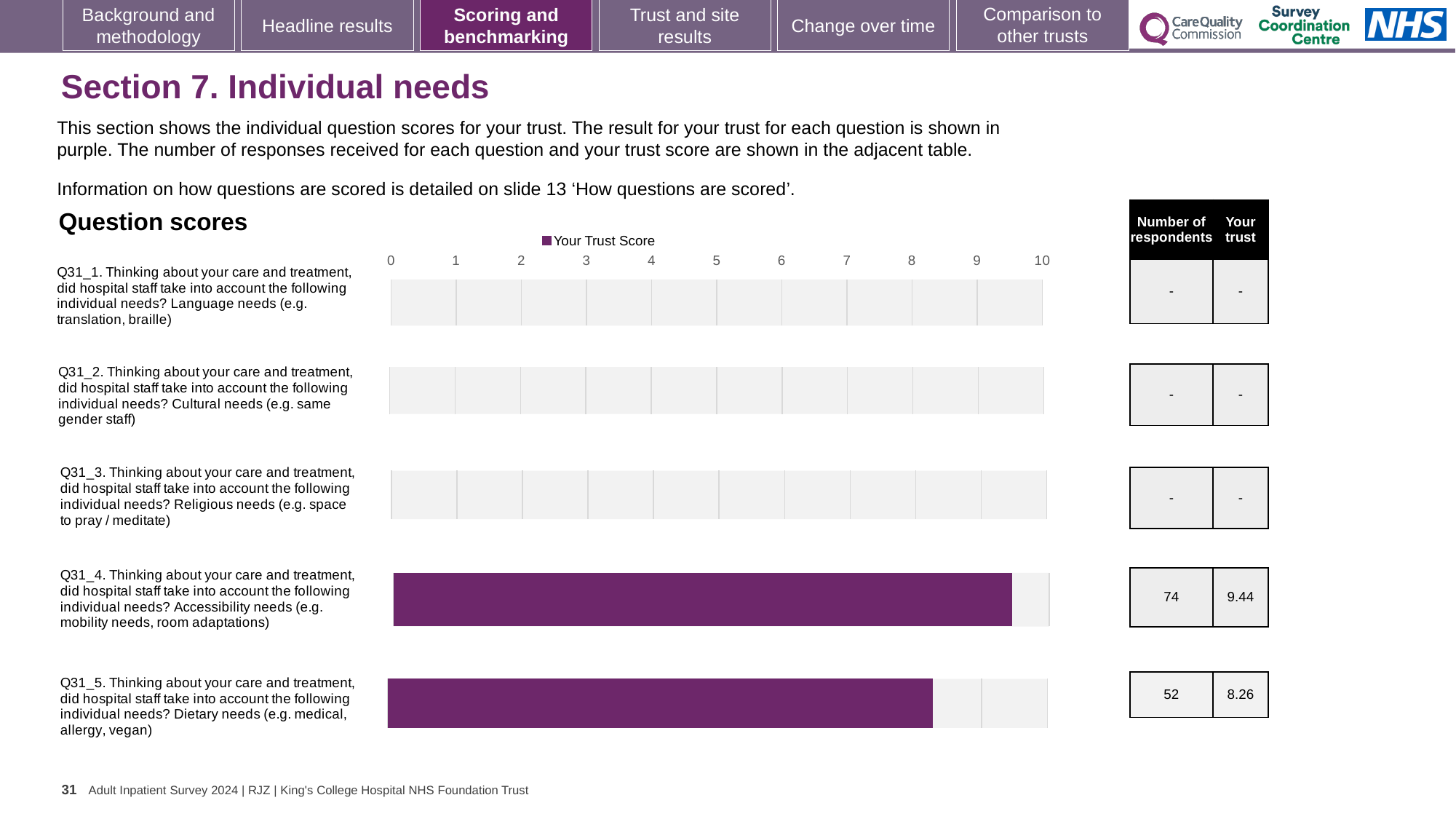
Which question has the highest trust score shown on the chart? Q31_4 (Accessibility needs) What series name is shown in the chart legend? Your Trust Score What is the trust score for Q31_4 (Accessibility needs)? 9.44 Is the value for Q31_5 (Dietary needs) greater or less than 9? less How many respondents answered Q31_5 (Dietary needs)? 52 What is the trust score for Q31_5 (Dietary needs)? 8.26 What is the difference between the trust scores for Q31_4 and Q31_5? 1.18 Which has the larger trust score, Q31_4 (Accessibility needs) or Q31_5 (Dietary needs)? Q31_4 (Accessibility needs) Is the value for Q31_4 (Accessibility needs) greater or less than 9? greater What type of chart is shown on the slide? Bar chart How many questions are listed on the chart? 5 How many respondents answered Q31_4 (Accessibility needs)? 74